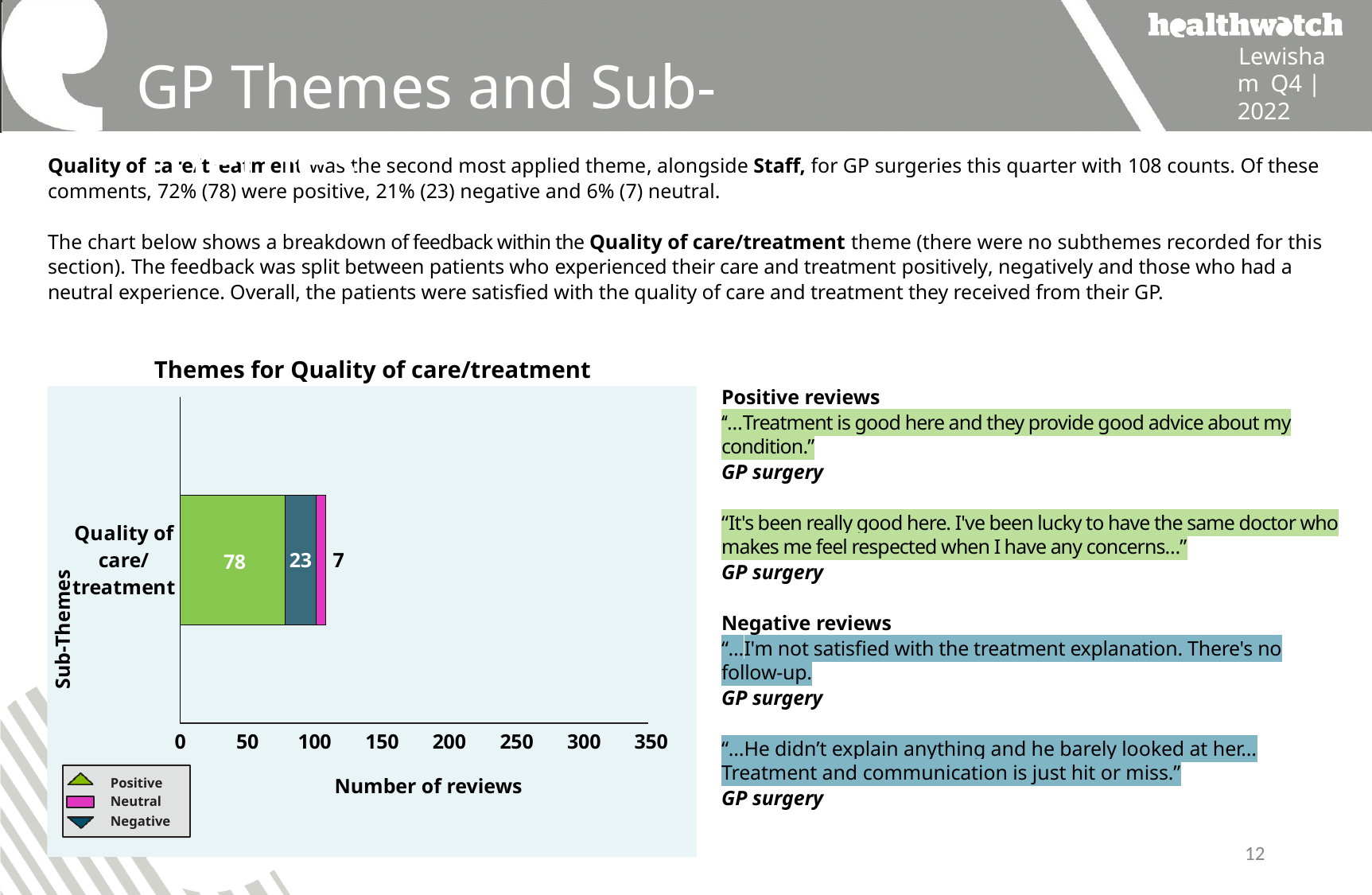
What is the value for Positive reviews in the Quality of care/treatment bar? 78 How many series does the legend list? 3 What is the title of the chart? Themes for Quality of care/treatment Which series has the lowest value in the chart? Neutral What is the difference between the Positive and Negative values? 55 What kind of chart is shown on the slide? Stacked bar chart What is the value for Negative reviews in the Quality of care/treatment bar? 23 What is the total of the stacked bar for Quality of care/treatment? 108 Which is larger, the Negative value or the Neutral value? Negative Which series has the highest value in the chart? Positive What is the value for Neutral reviews in the Quality of care/treatment bar? 7 Is the total length of the stacked bar greater or less than 150? less